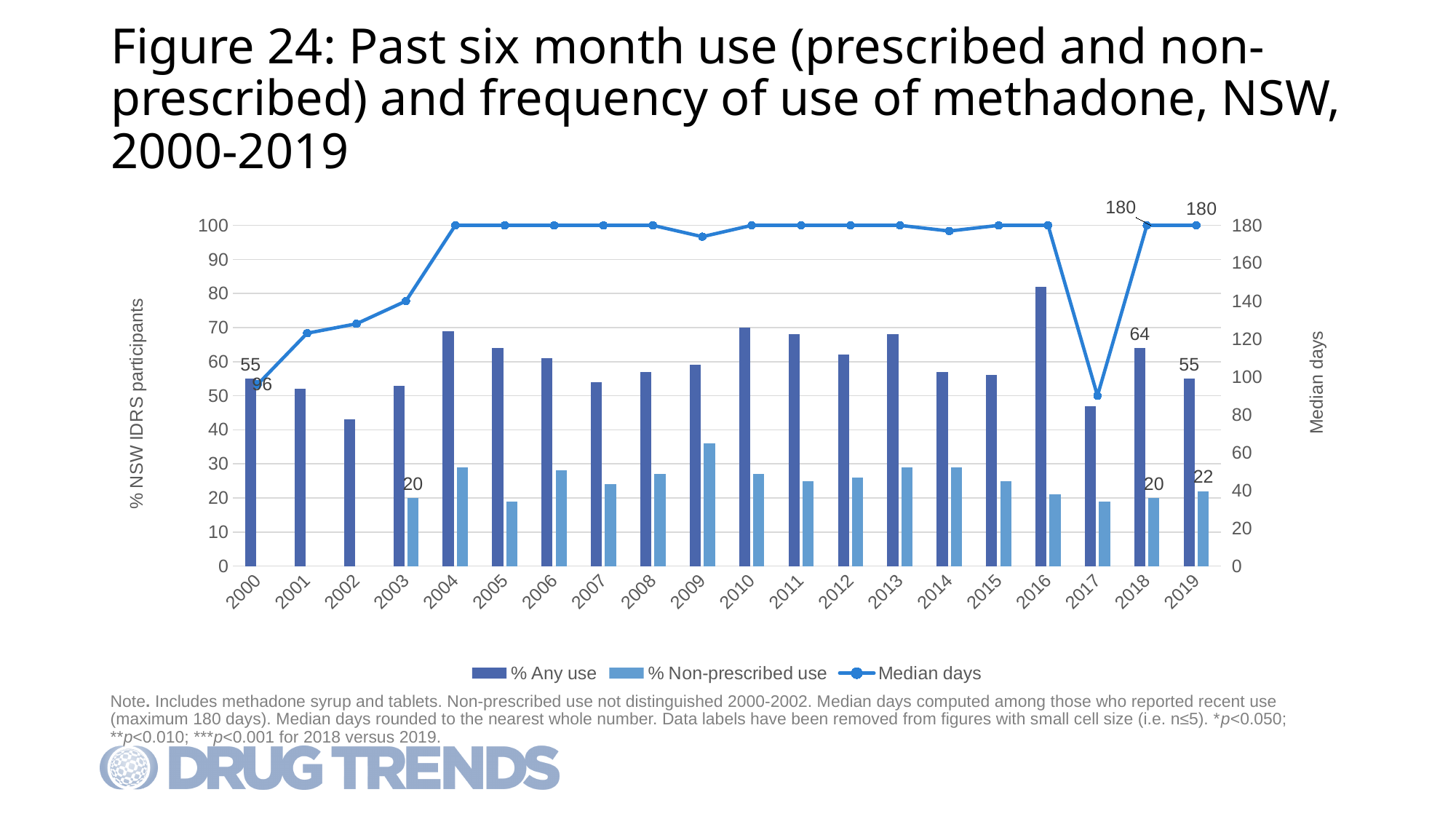
What is the difference between the % Any use values for 2018 and 2019? 9 What is the Median days value for 2000? 96 Which year has the larger % Non-prescribed use value, 2018 or 2019? 2019 What is the % Any use value for 2018? 64 Is the % Any use value for 2016 greater or less than 80? greater Which year has the lowest Median days value? 2017 How many years are shown on the x axis? 20 What is the % Non-prescribed use value for 2003? 20 How many series does the legend list? 3 What is the % Non-prescribed use value for 2019? 22 Which year has the lowest % Any use value? 2002 Which year has the highest % Any use value? 2016